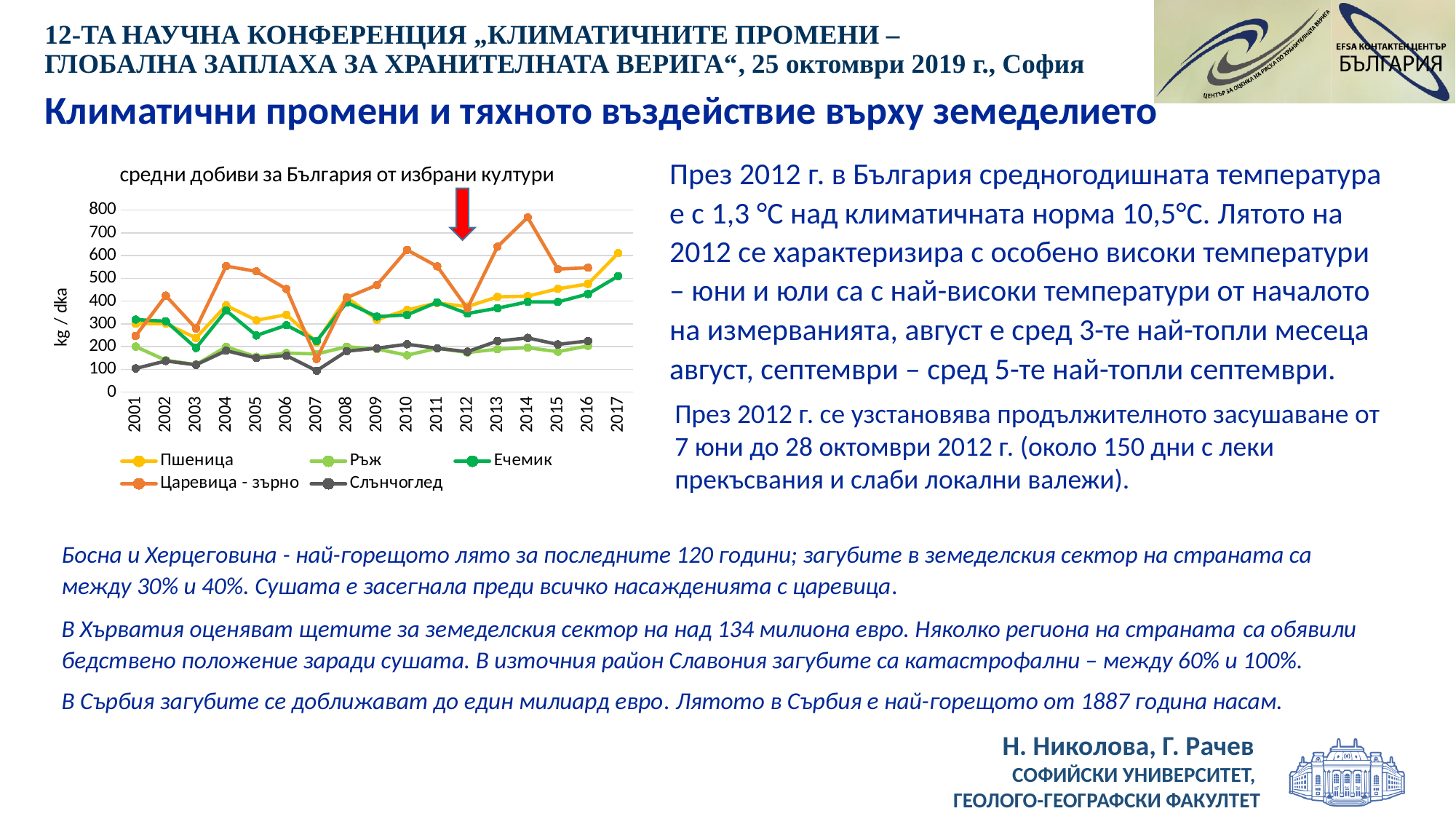
What unit is shown on the y axis of the chart? kg / dka Is the value for Царевица - зърно in 2007 greater or less than 200? less Is the value for Слънчоглед in 2014 greater or less than 200? greater In which year does the Царевица - зърно series reach its highest value? 2014 What kind of chart is shown on the slide? line chart Is the value for Царевица - зърно in 2014 greater or less than 700? greater What is the title of the chart? средни добиви за България от избрани култури In 2013, which is larger: the value for Царевица - зърно or the value for Пшеница? Царевица - зърно Which series has the lowest value in 2001? Слънчоглед Does the Пшеница series rise or fall from 2012 to 2017? rise How many years are shown on the x axis of the chart? 17 How many series does the chart legend list? 5